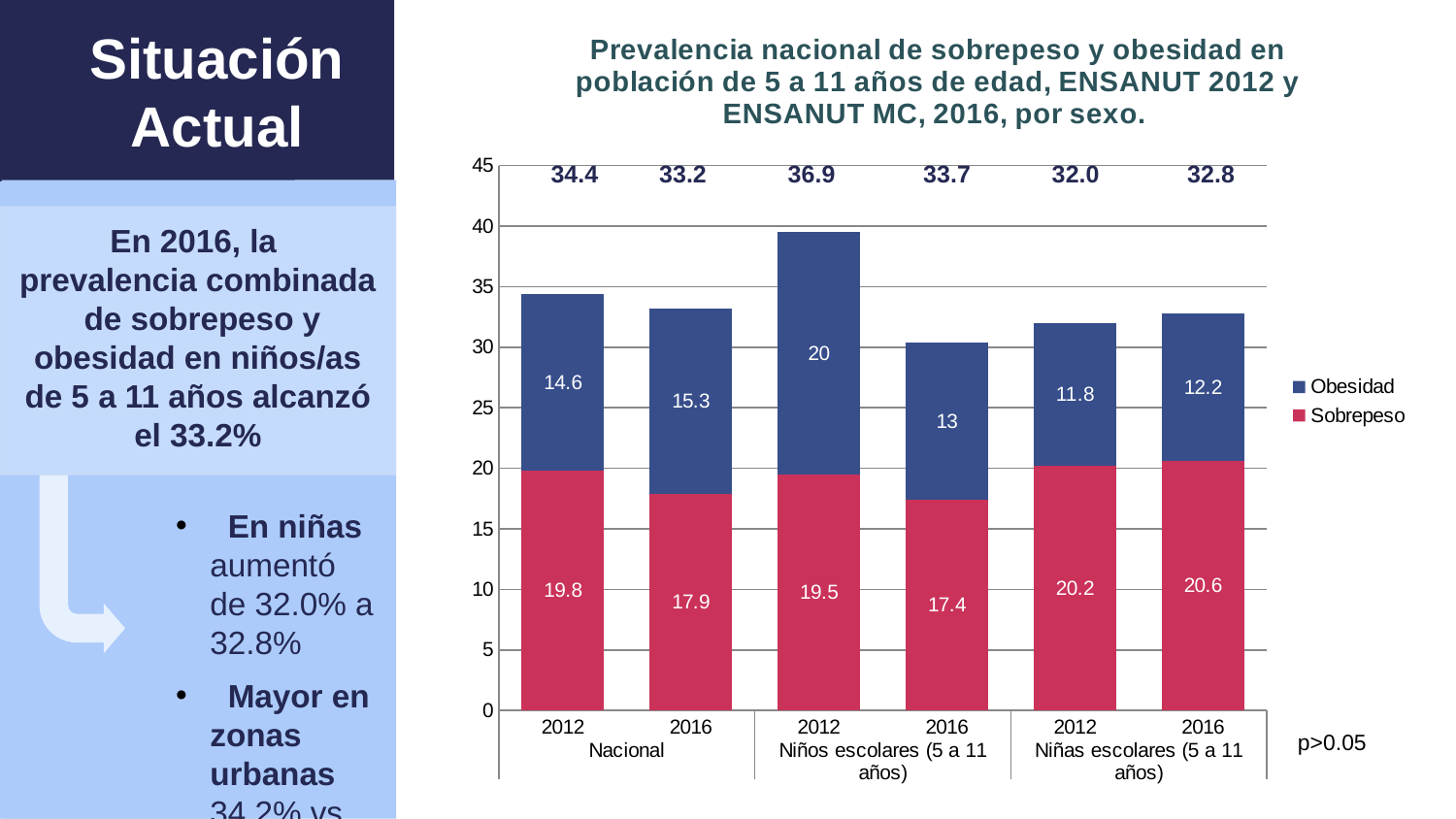
What kind of chart is shown on the slide? Stacked bar chart What is the difference between the Sobrepeso values for Nacional in 2012 and 2016? 1.9 How many bars are plotted in the chart? 6 Which bar has the lowest Obesidad value? Niñas escolares (5 a 11 años) 2012 What is the Sobrepeso value for Niños escolares (5 a 11 años) in 2016? 17.4 What is the Obesidad value for Niñas escolares (5 a 11 años) in 2016? 12.2 Is the Obesidad value larger for Nacional 2016 or for Niños escolares (5 a 11 años) 2016? Nacional 2016 Which bar has the highest Obesidad value? Niños escolares (5 a 11 años) 2012 How many series does the legend list? 2 What is the Obesidad value for Niños escolares (5 a 11 años) in 2012? 20 What is the Sobrepeso value for Nacional in 2012? 19.8 What is the total of the stacked bar for Nacional 2016? 33.2